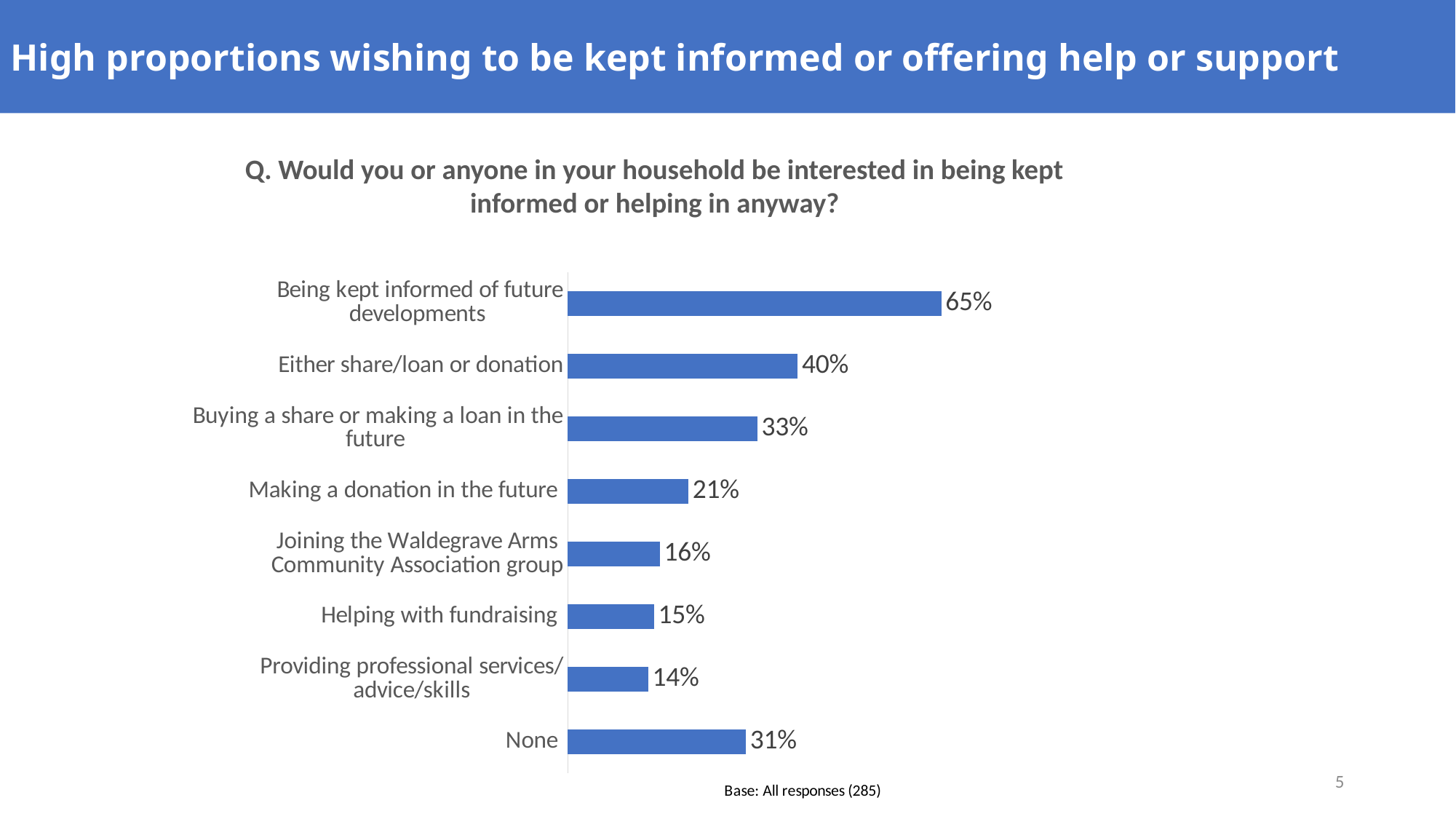
What percentage of respondents are interested in being kept informed of future developments? 65% What is the difference between 'Either share/loan or donation' and 'Making a donation in the future'? 19 percentage points What is the value for 'Joining the Waldegrave Arms Community Association group'? 16% Which category has the highest value? Being kept informed of future developments Which is larger: 'Buying a share or making a loan in the future' or 'None'? Buying a share or making a loan in the future What is the base (number of responses) stated below the chart? All responses (285) What type of chart is shown on the slide? Bar chart What is the value for 'Helping with fundraising'? 15% What is the difference between the highest and lowest values in the chart? 51 percentage points What percentage selected 'None'? 31% Which category has the lowest value? Providing professional services/advice/skills How many categories are shown in the chart? 8